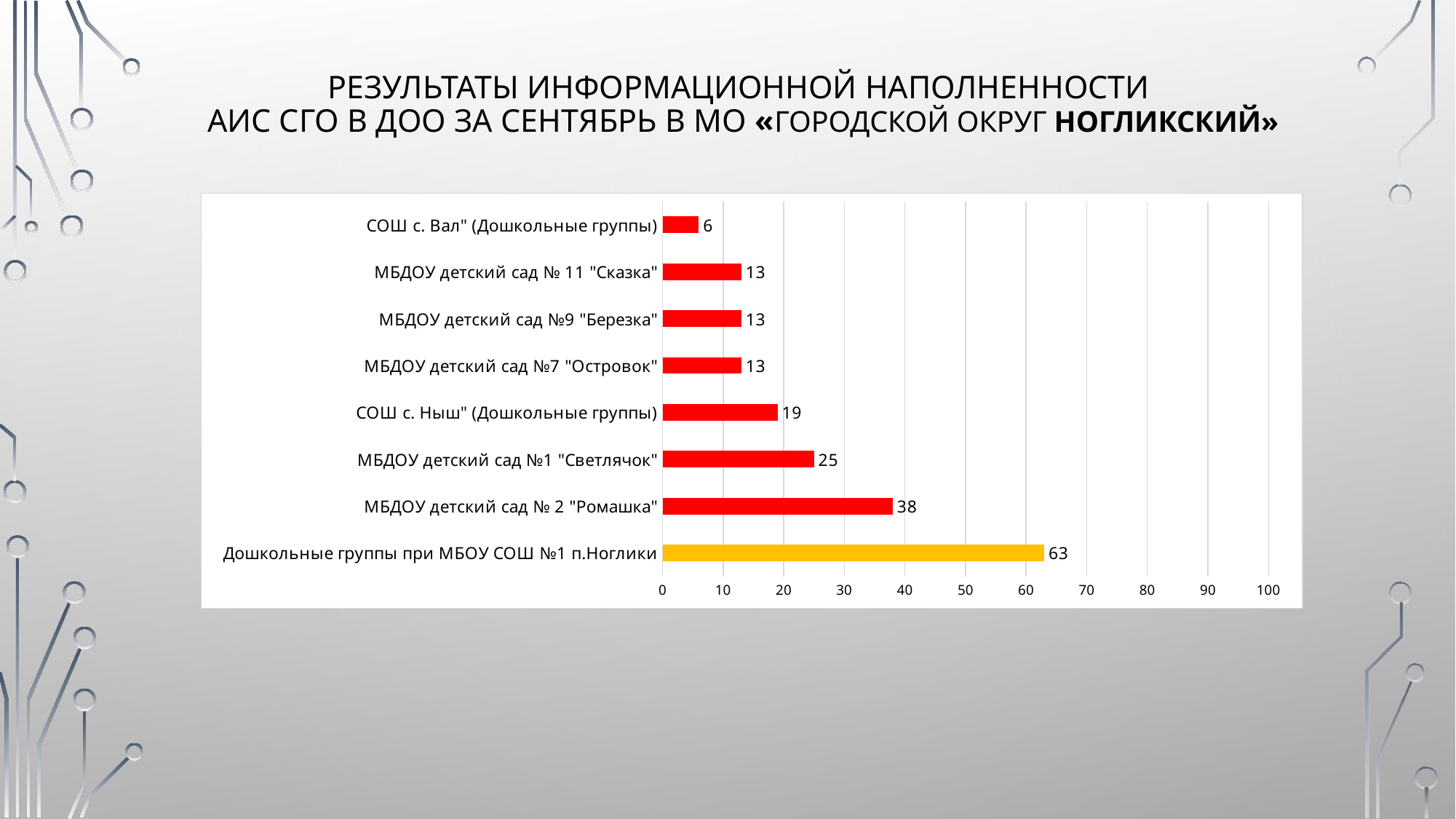
What is the difference between the values for Дошкольные группы при МБОУ СОШ №1 п.Ноглики and МБДОУ детский сад № 2 "Ромашка"? 25 Is the value for МБДОУ детский сад № 2 "Ромашка" greater or less than 40? less What is the value for СОШ с. Ныш" (Дошкольные группы)? 19 Which is larger, the value for МБДОУ детский сад №1 "Светлячок" or the value for СОШ с. Ныш" (Дошкольные группы)? МБДОУ детский сад №1 "Светлячок" What is the value for СОШ с. Вал" (Дошкольные группы)? 6 How many categories are shown in the chart? 8 What is the value for Дошкольные группы при МБОУ СОШ №1 п.Ноглики? 63 Which category has the lowest value? СОШ с. Вал" (Дошкольные группы) What kind of chart is shown on the slide? bar chart Which category has the highest value? Дошкольные группы при МБОУ СОШ №1 п.Ноглики Which bar is coloured differently (yellow) from the others? Дошкольные группы при МБОУ СОШ №1 п.Ноглики What is the value for МБДОУ детский сад № 2 "Ромашка"? 38